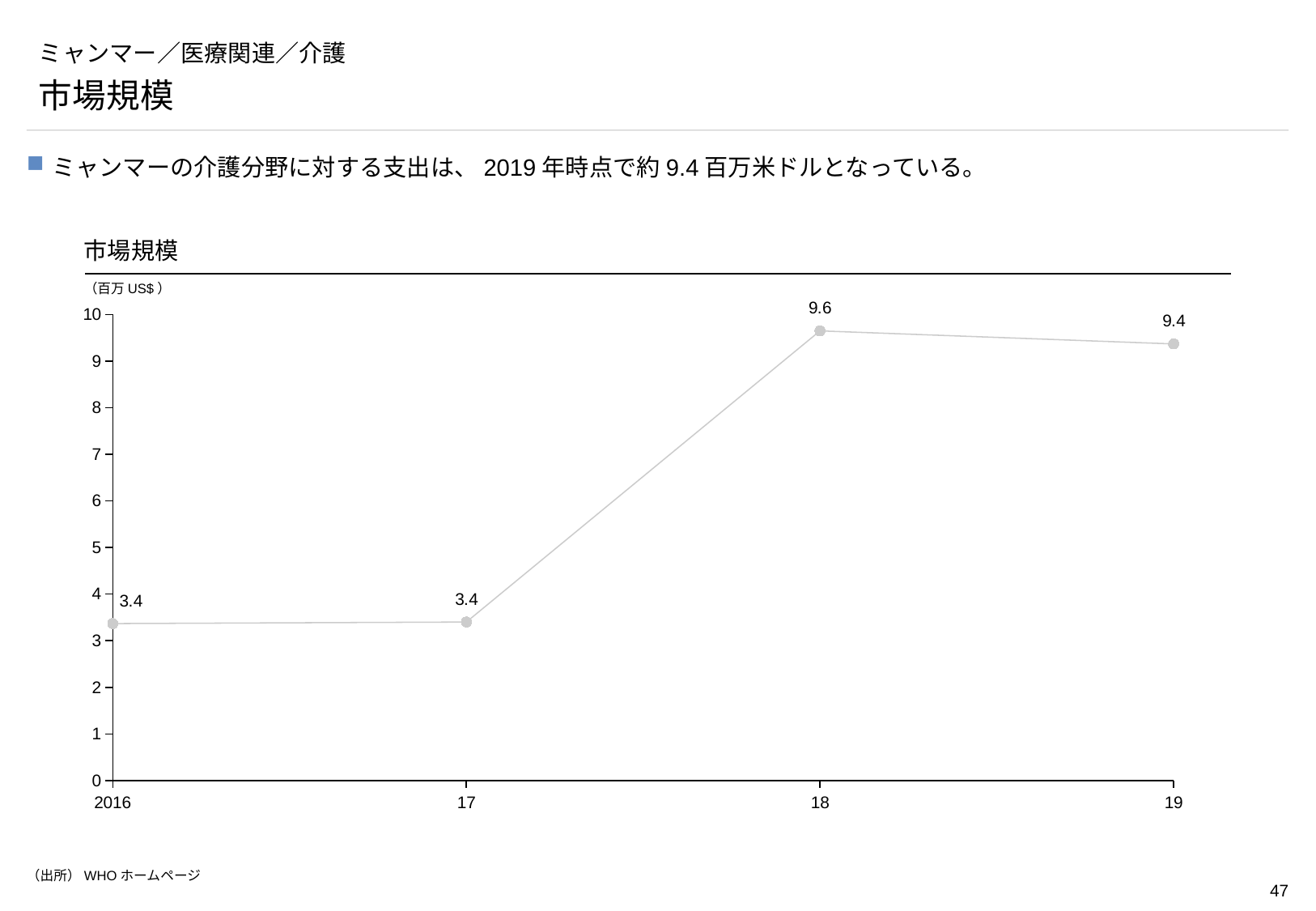
Does the value rise or fall from 17 to 18? rise What is the value for 18 (2018)? 9.6 What unit is shown for the chart's values? 百万 US$ What is the value for 2016? 3.4 What is the difference between the values for 18 and 17? 6.2 What is the difference between the values for 18 and 19? 0.2 Is the value for 18 greater or less than 5? greater Which year has the highest value? 18 Which is larger, the value for 17 or the value for 19? 19 How many data points are plotted on the chart? 4 What is the value for 19 (2019)? 9.4 What kind of chart is shown on the slide? line chart